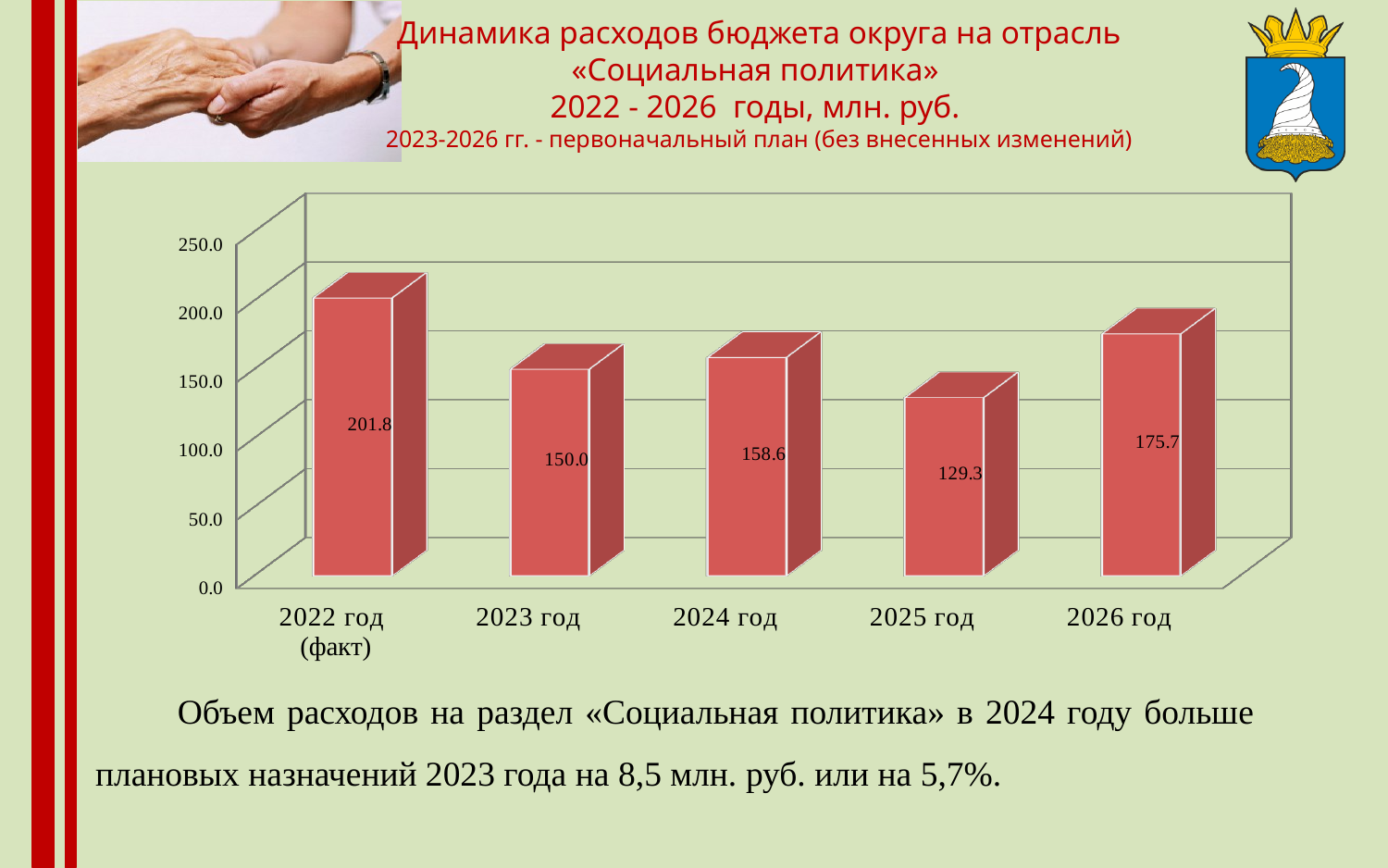
What is the value for 2026 год? 175.7 What kind of chart is shown on the slide? bar chart How many years are shown on the chart? 5 Do the values rise or fall from 2024 год to 2025 год? fall Which year has the lowest value? 2025 год What is the difference between the values for 2024 год and 2023 год? 8.6 What is the value for 2022 год (факт)? 201.8 Is the value for 2023 год greater or less than 200.0? less Which year has the highest value? 2022 год (факт) What is the value for 2025 год? 129.3 Which is larger, the value for 2024 год or the value for 2026 год? 2026 год What is the difference between the values for 2022 год (факт) and 2026 год? 26.1